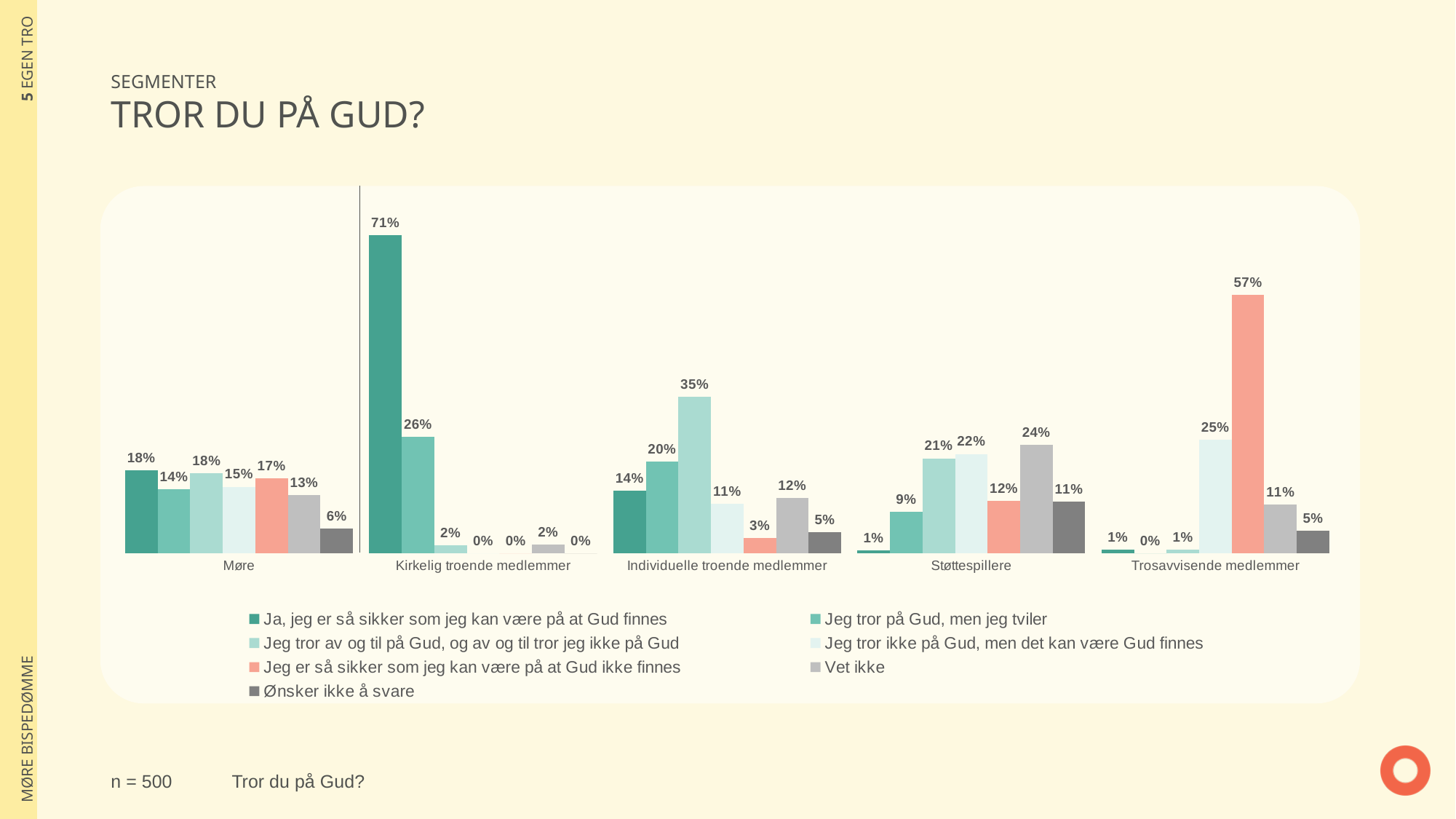
What is the value for "Jeg er så sikker som jeg kan være på at Gud ikke finnes" in the Trosavvisende medlemmer category? 57% What is the sample size stated on the slide? n = 500 Which series has the highest value in the Møre category? Ja, jeg er så sikker som jeg kan være på at Gud finnes and Jeg tror av og til på Gud, og av og til tror jeg ikke på Gud (both 18%) What is the value for "Ja, jeg er så sikker som jeg kan være på at Gud finnes" in the Kirkelig troende medlemmer category? 71% What is the value for "Vet ikke" in the Støttespillere category? 24% How many series does the legend list? 7 Which series has the lowest value in the Møre category? Ønsker ikke å svare What is the difference between the "Ja, jeg er så sikker som jeg kan være på at Gud finnes" value for Kirkelig troende medlemmer and for Individuelle troende medlemmer? 57% Which is larger: the "Jeg tror på Gud, men jeg tviler" value for Kirkelig troende medlemmer or for Individuelle troende medlemmer? Kirkelig troende medlemmer What is the value for "Jeg tror av og til på Gud, og av og til tror jeg ikke på Gud" in the Individuelle troende medlemmer category? 35% What type of chart is shown on the slide? bar chart How many categories are shown along the x axis? 5